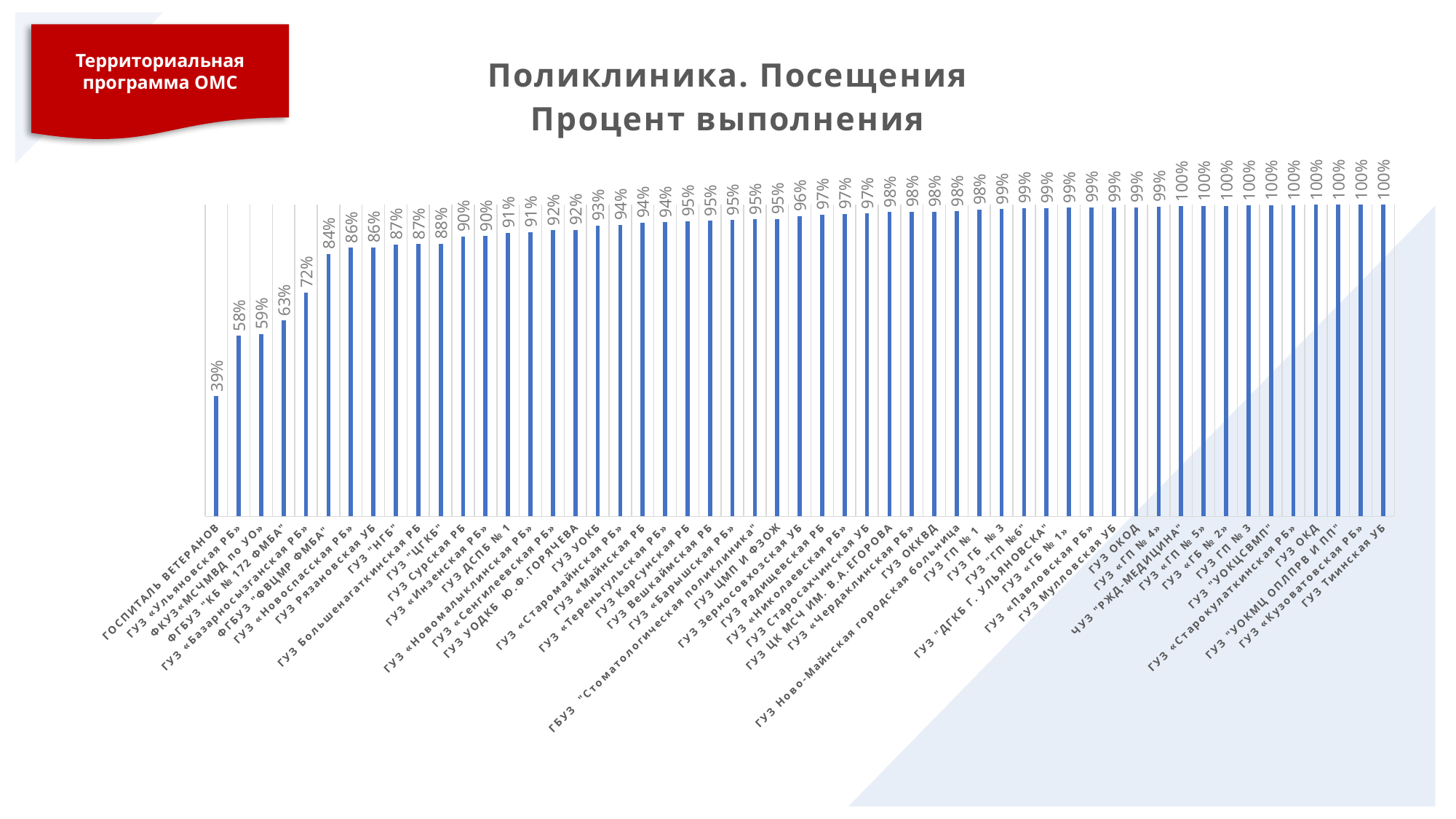
What is the value for ФГБУЗ "КБ № 172 ФМБА"? 63% What is the difference between the values for ФГБУЗ "КБ № 172 ФМБА" and ГУЗ «Ульяновская РБ»? 5% What is the value for ГУЗ «Ульяновская РБ»? 58% What is the value for ФГБУЗ "ФВЦМР ФМБА"? 84% What is the value for ГУЗ «Базарносызганская РБ»? 72% What is the difference between the values for ГУЗ «Базарносызганская РБ» and ГОСПИТАЛЬ ВЕТЕРАНОВ? 33% Which category has the lowest percentage on the chart? ГОСПИТАЛЬ ВЕТЕРАНОВ Which is larger, the value for ГУЗ «Базарносызганская РБ» or the value for ФКУЗ«МСЧ МВД по УО»? ГУЗ «Базарносызганская РБ» What is the title of the chart? Поликлиника. Посещения Процент выполнения What is the percentage shown for ГОСПИТАЛЬ ВЕТЕРАНОВ? 39% Do the values rise or fall from left to right along the x axis? Rise What kind of chart is shown on the slide? Bar chart